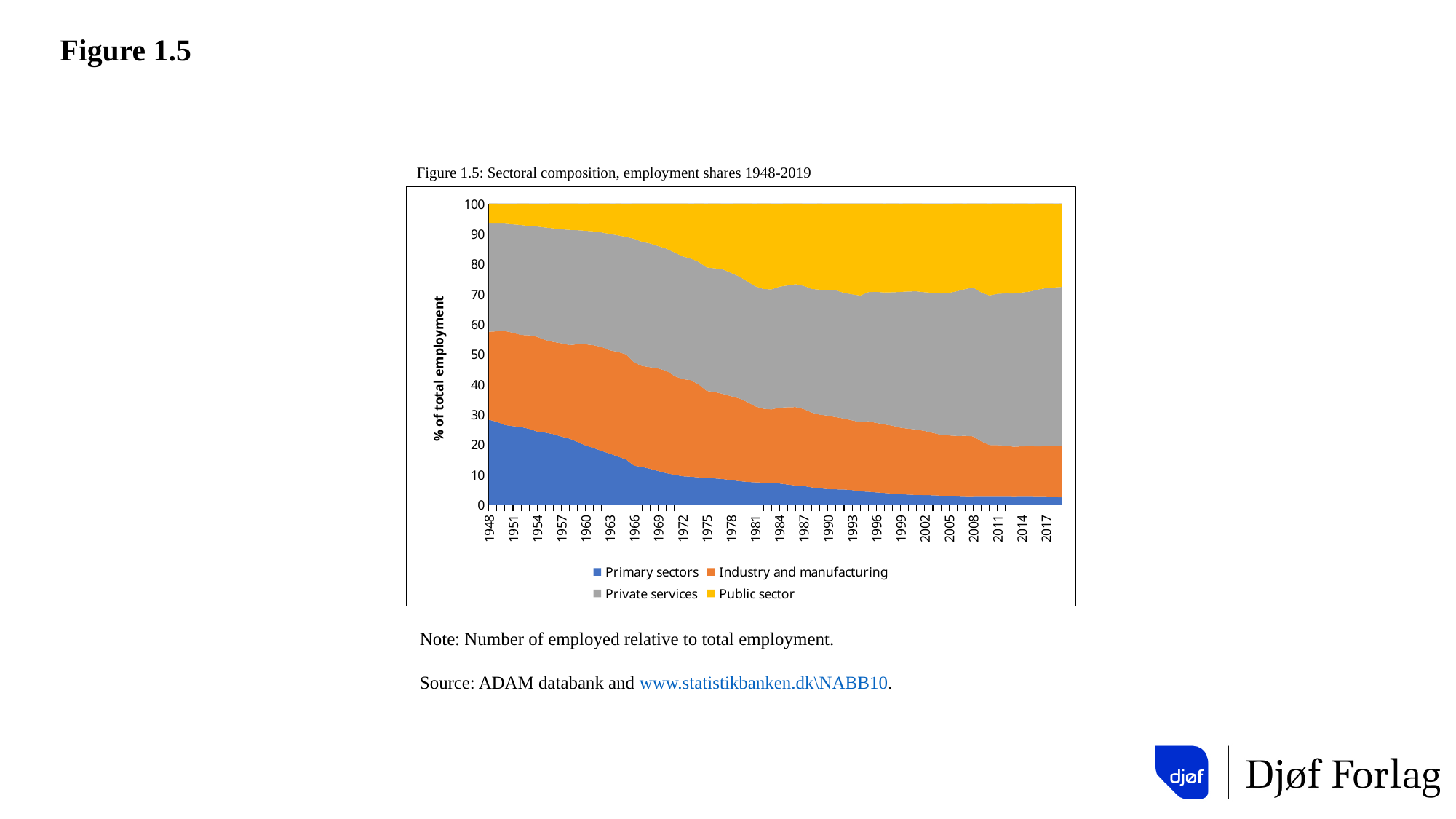
What is the title of the chart? Figure 1.5: Sectoral composition, employment shares 1948-2019 Is the cumulative top of the Private services band in 2017 greater or less than 80? less Does the Primary sectors share rise or fall from 1948 to 2019? Fall In 1948, which share is larger: Primary sectors or Public sector? Primary sectors Does the Public sector share rise or fall from 1948 to 2019? Rise Is the Primary sectors share in 1948 greater or less than 20? greater What is the label on the vertical axis? % of total employment How many series does the legend list? 4 Is the Primary sectors share in 2017 greater or less than 10? less What kind of chart is shown on the slide? Stacked area chart In 2017, which share is larger: Public sector or Primary sectors? Public sector